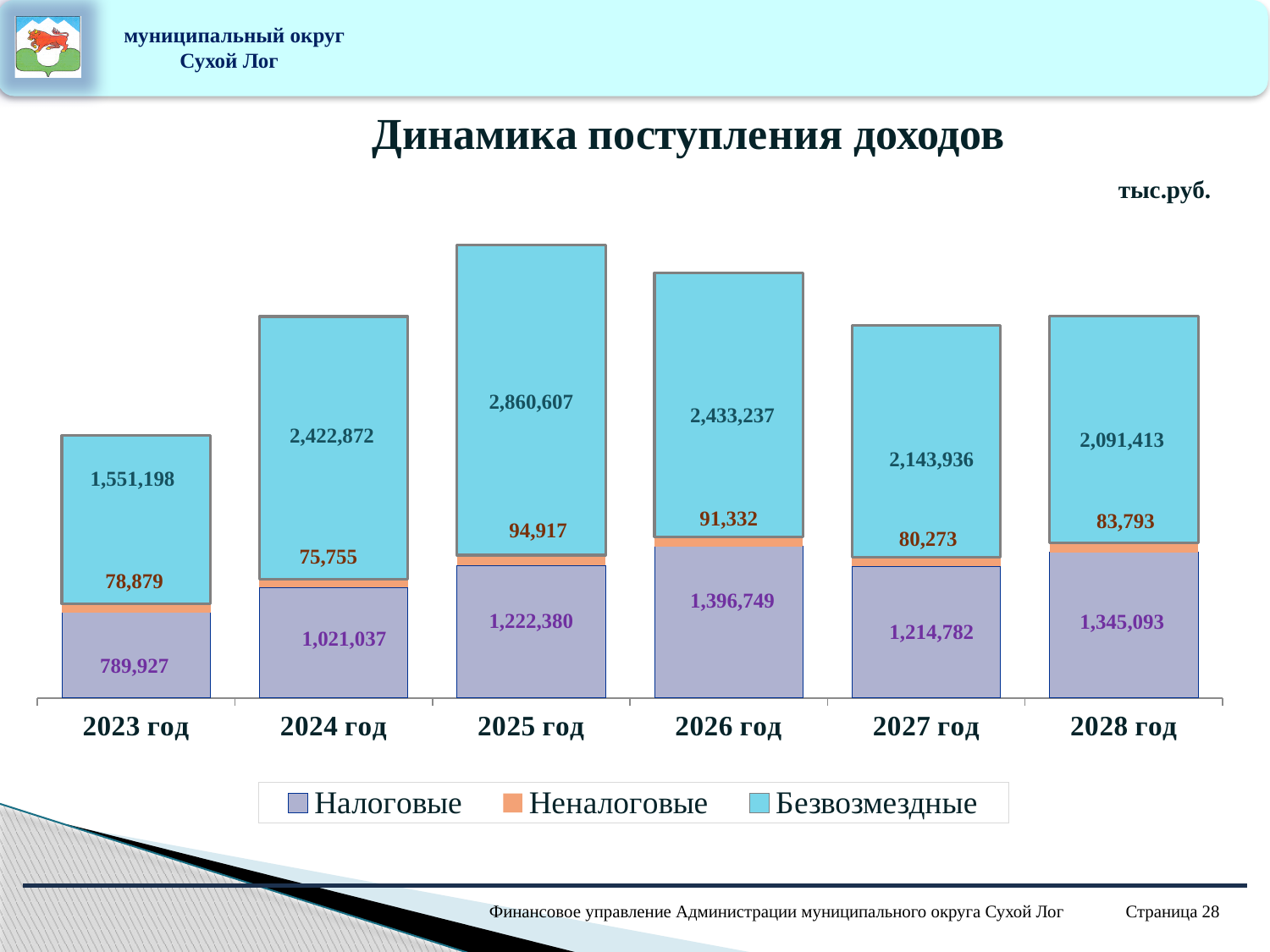
What is the value of Безвозмездные for 2025 год? 2,860,607 In which year is the Безвозмездные value highest? 2025 год What is the difference between the Безвозмездные values for 2025 год and 2024 год? 437,735 What kind of chart is shown on the slide? Stacked bar chart How many years are shown on the x axis? 6 What is the value of Неналоговые for 2027 год? 80,273 What is the value of Налоговые for 2023 год? 789,927 What is the total of the stacked bar for 2023 год? 2,420,004 Do the Налоговые values rise or fall from 2023 год to 2026 год? Rise In which year is the Неналоговые value lowest? 2024 год Which is larger: Налоговые for 2026 год or Налоговые for 2028 год? 2026 год How many series does the legend list? 3